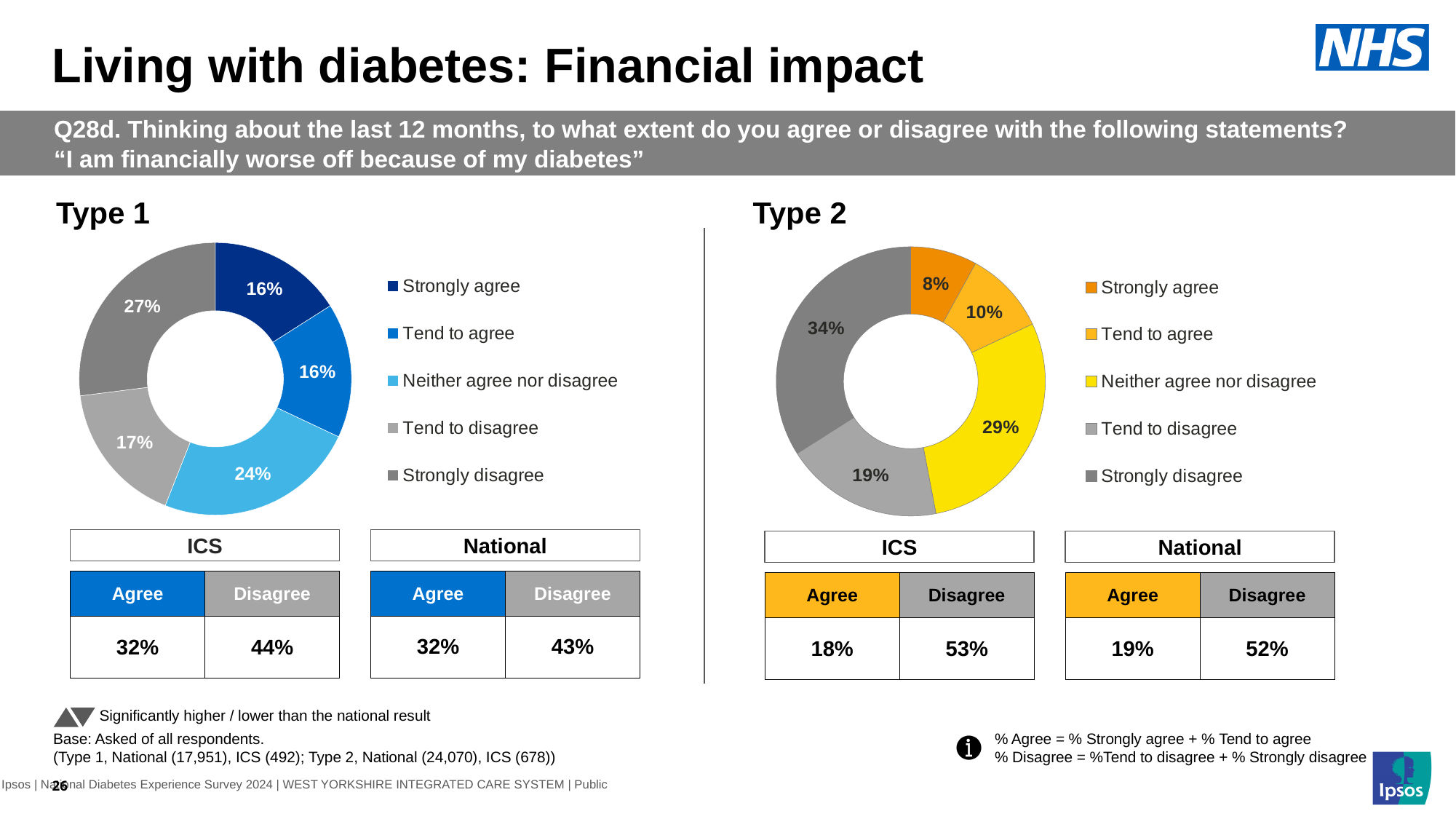
In the Type 2 chart, what percentage of respondents said 'Tend to disagree'? 19% What type of chart is used for the Type 2 data? Donut chart In the Type 2 chart, what colour represents 'Neither agree nor disagree'? Yellow In the Type 1 chart, what colour represents 'Strongly agree'? Dark blue In the Type 1 chart, what percentage of respondents said 'Neither agree nor disagree'? 24% In the Type 2 chart, which is larger: 'Tend to agree' or 'Tend to disagree'? Tend to disagree In the Type 2 chart, which response category has the smallest share? Strongly agree In the Type 1 chart, which response category has the largest share? Strongly disagree In the Type 1 chart, what is the difference in percentage points between 'Strongly disagree' and 'Tend to disagree'? 10 In the Type 2 chart, what percentage of respondents said 'Strongly agree'? 8% In the Type 2 chart, what is the difference in percentage points between 'Strongly disagree' and 'Neither agree nor disagree'? 5 In the Type 1 chart, how many response categories are shown? 5